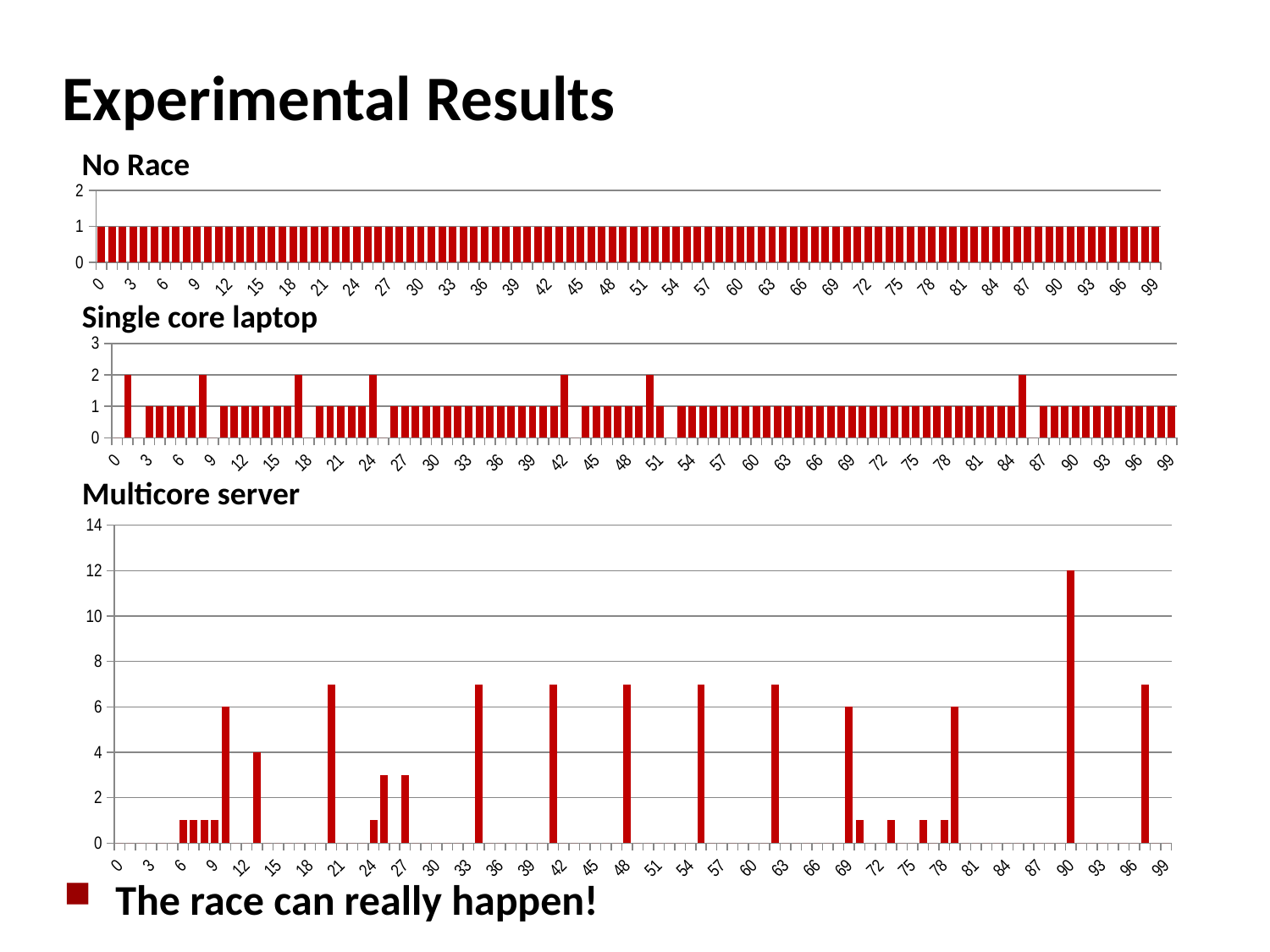
In the 'Multicore server' chart, which category has the highest value? 90 In the 'No Race' chart, do the values rise, fall, or stay constant along the x axis? stay constant In the 'Multicore server' chart, which is larger: the value for category 90 or the value for category 20? 90 What is the highest tick shown on the y axis of the 'Multicore server' chart? 14 In the 'No Race' chart, what is the value for category 0? 1 In the 'Single core laptop' chart, what is the highest value reached by any bar? 2 What kind of chart is the 'No Race' chart? bar chart In the 'Multicore server' chart, what is the value for category 0? 0 In the 'Multicore server' chart, what is the value for category 90? 12 How many charts are shown on the slide? 3 In the 'Multicore server' chart, is the value for category 90 greater or less than 10? greater